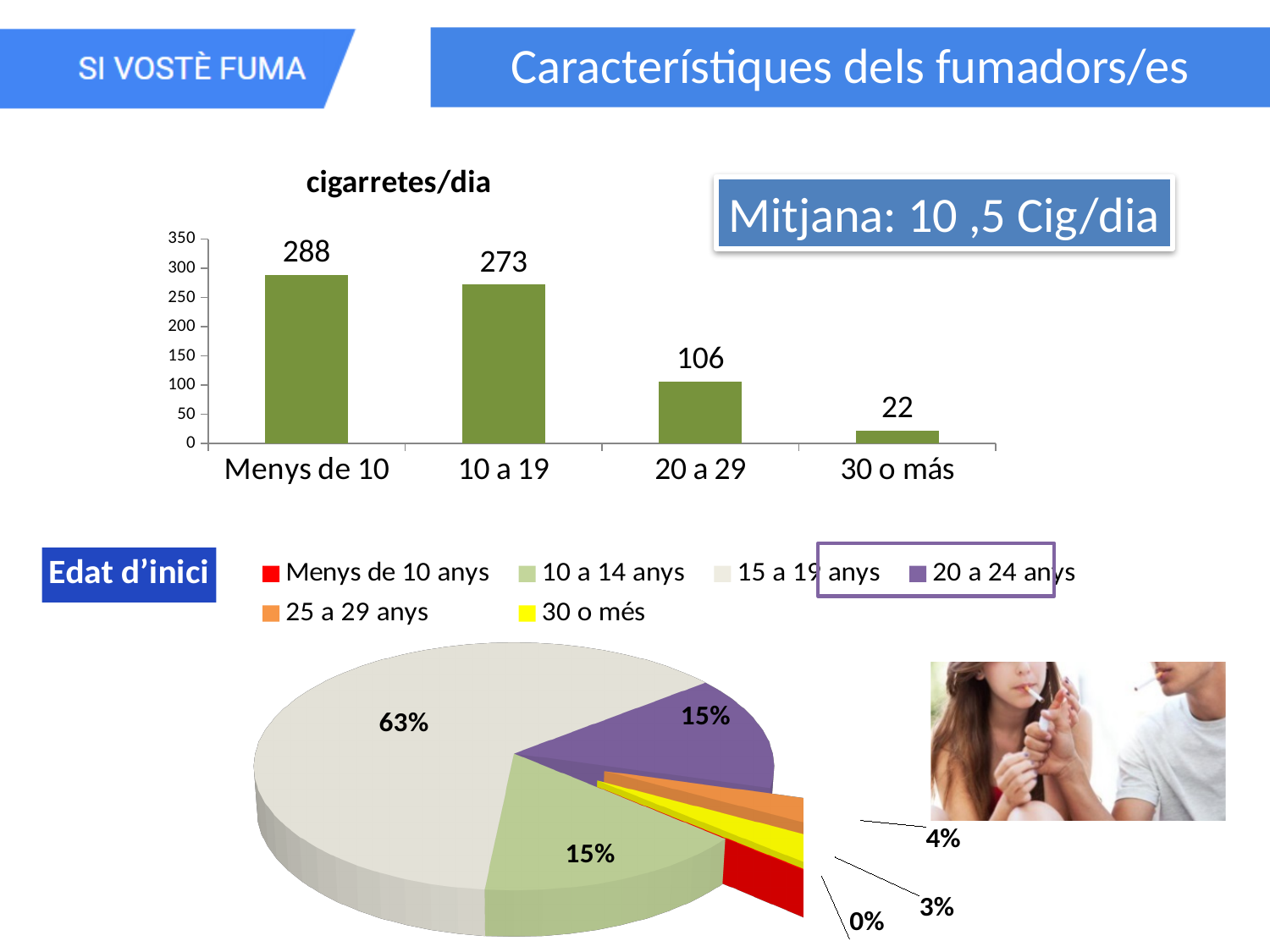
In the 'Edat d'inici' pie chart, how many entries does the legend list? 6 In the 'Edat d'inici' pie chart, what colour is the '20 a 24 anys' slice? purple In the 'cigarretes/dia' bar chart, what is the value for 'Menys de 10'? 288 In the 'Edat d'inici' pie chart, what share does the '15 a 19 anys' slice have? 63% In the 'cigarretes/dia' bar chart, how many categories are shown on the x axis? 4 In the 'cigarretes/dia' bar chart, which category has the lowest value? 30 o más What kind of chart is the 'cigarretes/dia' chart? bar chart In the 'cigarretes/dia' bar chart, what is the difference between the values for 'Menys de 10' and '10 a 19'? 15 In the 'cigarretes/dia' bar chart, do the values rise or fall from left to right along the x axis? fall In the 'Edat d'inici' pie chart, what share does the '20 a 24 anys' slice have? 15% In the 'cigarretes/dia' bar chart, what is the value for '20 a 29'? 106 In the 'cigarretes/dia' bar chart, which category has the highest value? Menys de 10